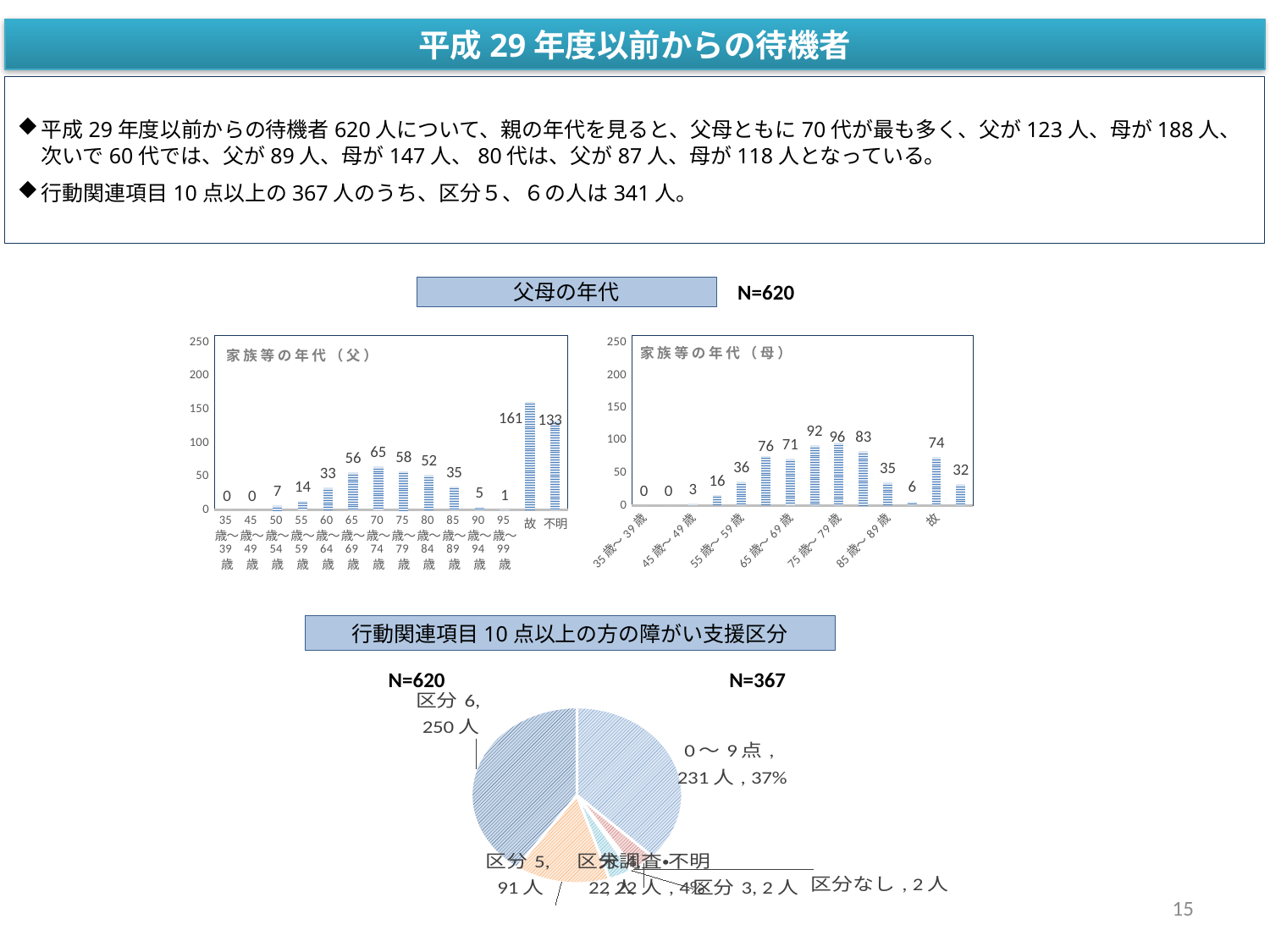
In the pie chart 行動関連項目10点以上の方の障がい支援区分, how many people are in 区分5? 91人 In the 家族等の年代（母） chart, which is larger, the value for 45歳〜49歳 or the value for 55歳〜59歳? 55歳〜59歳 In the pie chart 行動関連項目10点以上の方の障がい支援区分, how many people are in 区分6? 250人 In the 家族等の年代（父） chart, what is the difference between the values for 故 and 不明? 28 In the 家族等の年代（母） chart, what is the value for 75歳〜79歳? 96 How many categories are shown in the 家族等の年代（父） chart? 14 In the 家族等の年代（父） chart, which category has the highest value? 故 In the 家族等の年代（父） chart, what is the value for 70〜74歳? 65 In the 家族等の年代（母） chart, what is the value for 故? 74 What kind of chart is the 家族等の年代（父） chart? bar chart In the pie chart 行動関連項目10点以上の方の障がい支援区分, what share of the pie is the 0〜9点 slice? 37% In the 家族等の年代（父） chart, what is the value for 不明? 133